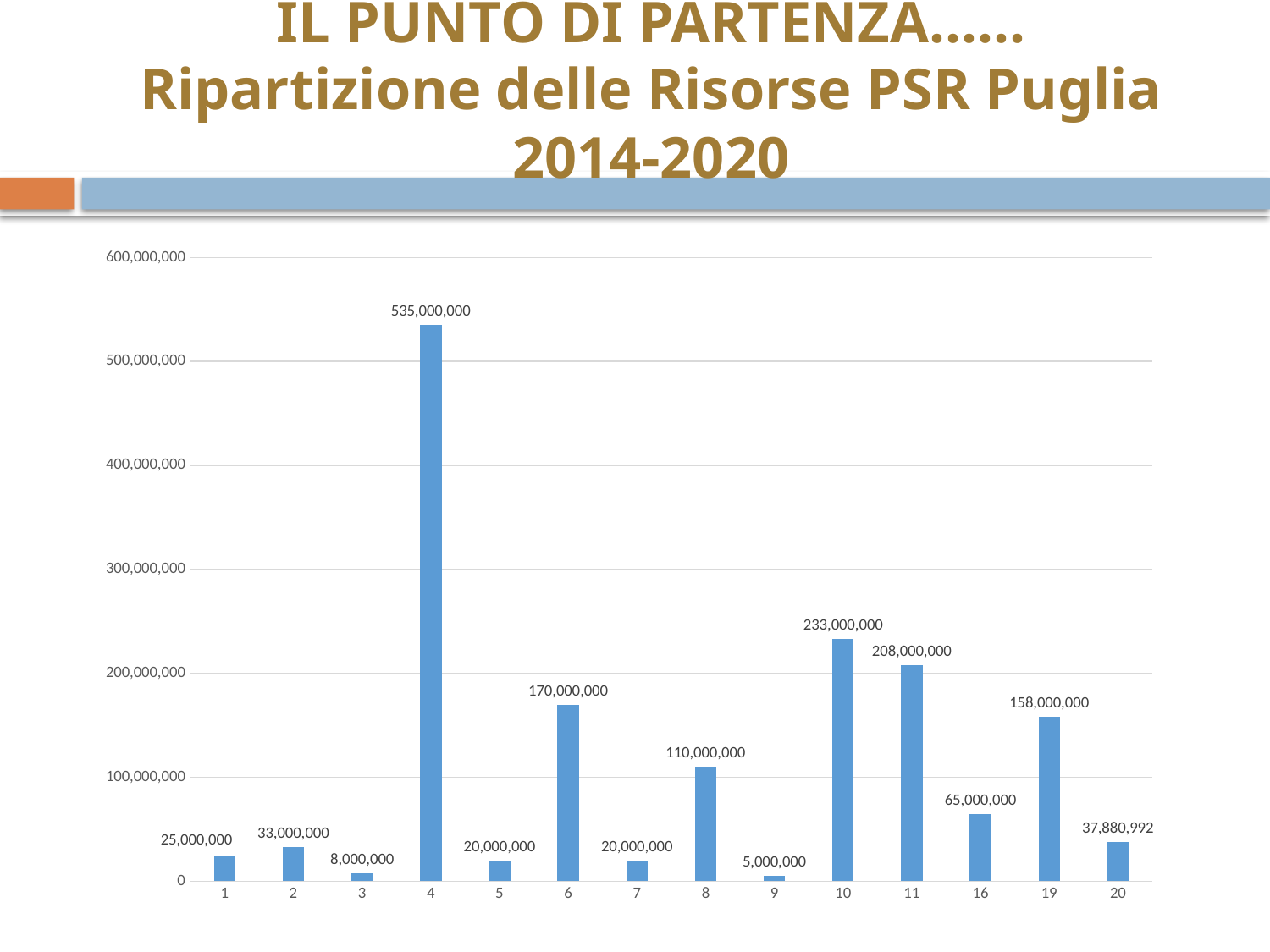
What is the difference between the values for category 10 and category 11? 25,000,000 What is the value for category 10? 233,000,000 What is the highest value shown on the y axis? 600,000,000 What is the value for category 4? 535,000,000 Which category has the highest value? 4 Which category has the lowest value? 9 What kind of chart is shown on the slide? bar chart What is the value for category 20? 37,880,992 Is the value for category 8 greater or less than 100,000,000? greater Which is larger, the value for category 6 or the value for category 19? category 6 What is the difference between the values for category 4 and category 10? 302,000,000 How many categories are shown on the x axis? 14